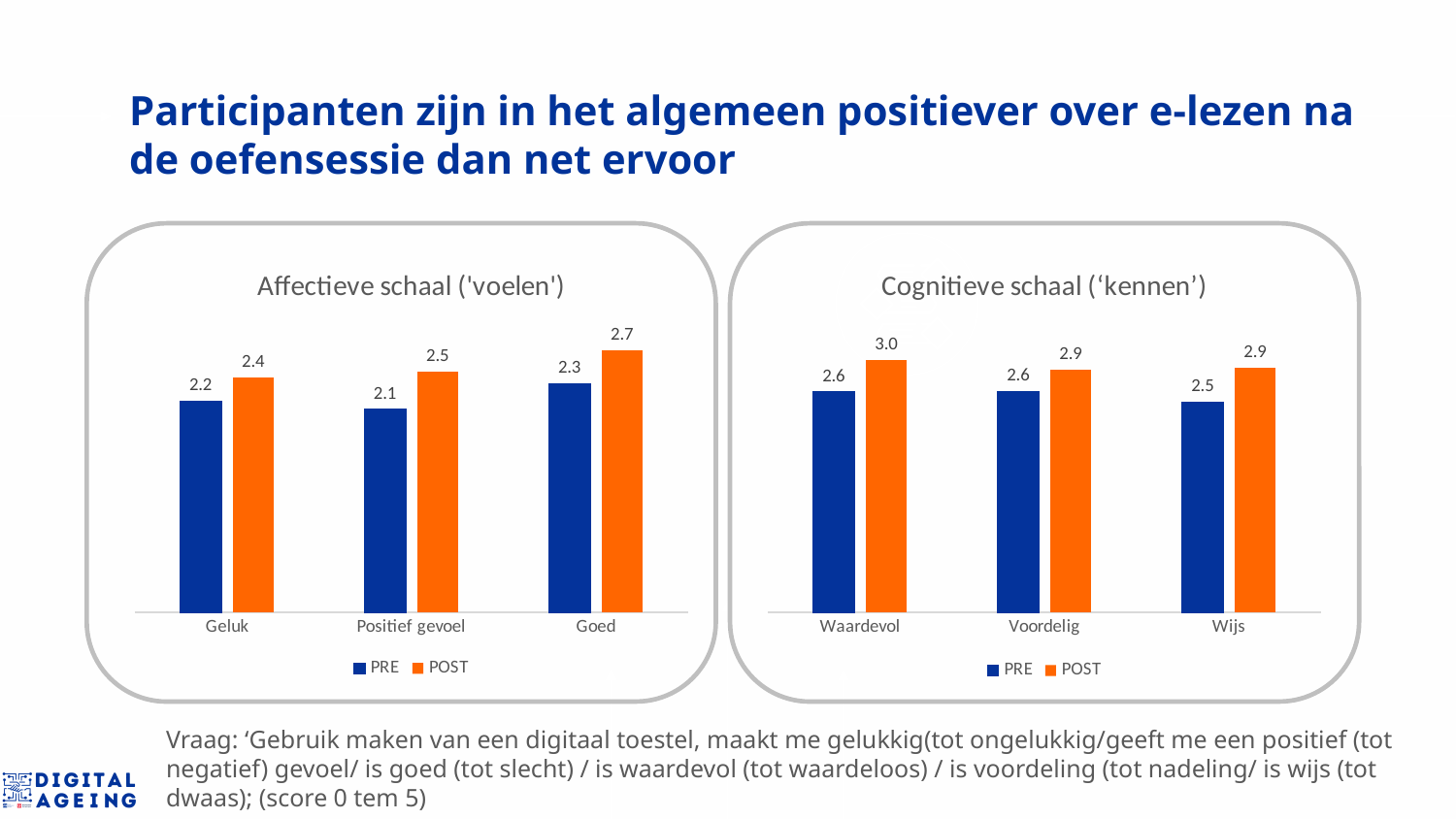
In the 'Cognitieve schaal ('kennen')' chart, which colour represents the POST series? Orange How many series does the legend of the 'Cognitieve schaal ('kennen')' chart list? 2 How many categories are shown in the 'Affectieve schaal ('voelen')' chart? 3 In the 'Cognitieve schaal ('kennen')' chart, what is the difference between the POST and PRE values for Waardevol? 0.4 In the 'Cognitieve schaal ('kennen')' chart, which is larger: the PRE value for Voordelig or the PRE value for Wijs? PRE value for Voordelig In the 'Affectieve schaal ('voelen')' chart, what is the difference between the POST and PRE values for Goed? 0.4 In the 'Affectieve schaal ('voelen')' chart, what is the POST value for Positief gevoel? 2.5 In the 'Affectieve schaal ('voelen')' chart, which category has the lowest PRE value? Positief gevoel In the 'Affectieve schaal ('voelen')' chart, which category has the highest POST value? Goed In the 'Cognitieve schaal ('kennen')' chart, what is the PRE value for Wijs? 2.5 In the 'Cognitieve schaal ('kennen')' chart, which category has the highest POST value? Waardevol What type of chart is the 'Affectieve schaal ('voelen')' chart? Bar chart